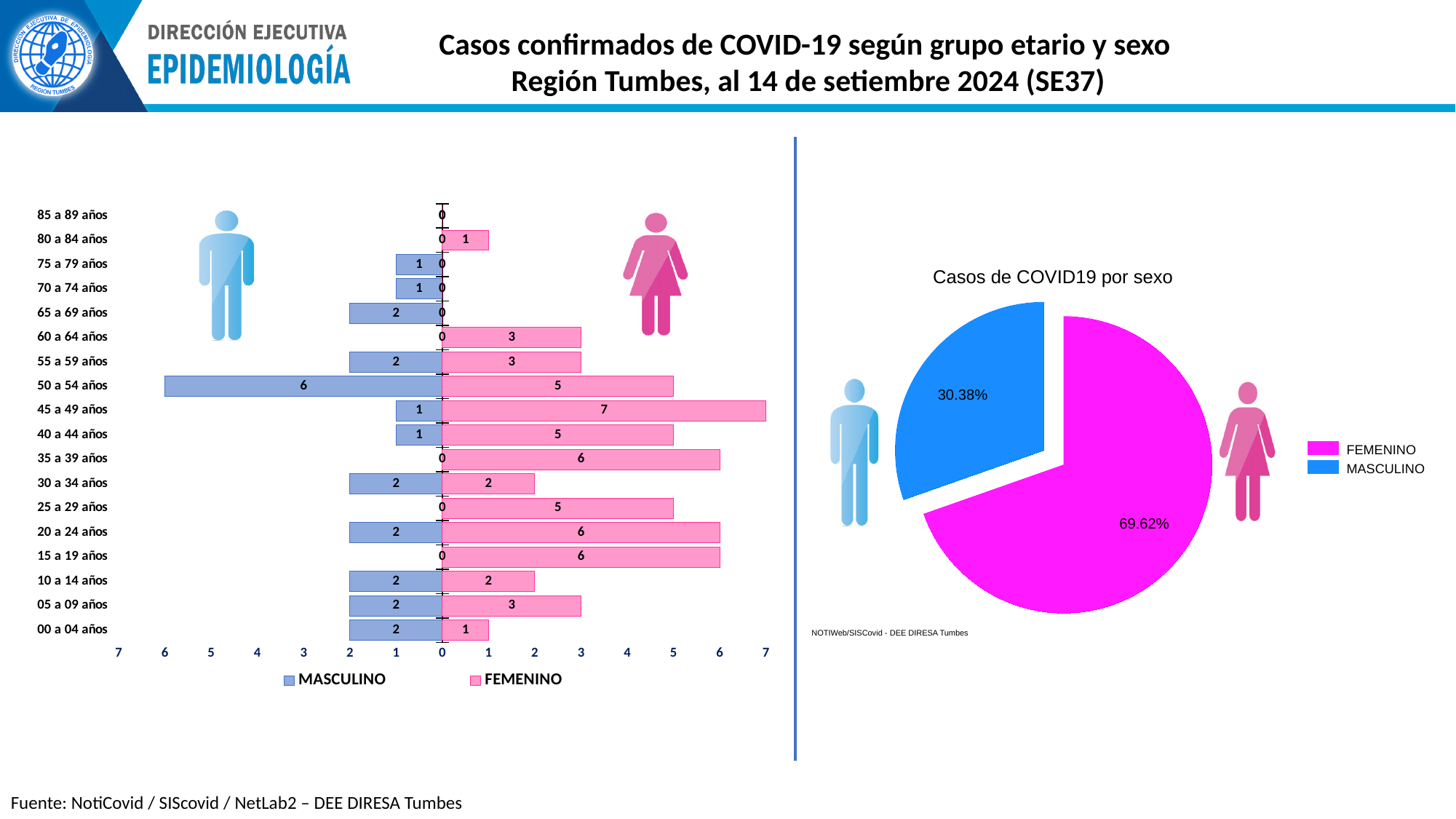
In the left chart (age group and sex), what is the difference between the FEMENINO and MASCULINO values for 45 a 49 años? 6 In the left chart (age group and sex), what is the MASCULINO value for 50 a 54 años? 6 In the left chart (age group and sex), which age group has the highest FEMENINO value? 45 a 49 años What kind of chart is the left chart showing cases by age group and sex? Bar chart In the left chart (age group and sex), how many series does the legend list? 2 In the left chart (age group and sex), what is the FEMENINO value for 45 a 49 años? 7 In the pie chart 'Casos de COVID19 por sexo', what share is MASCULINO? 30.38% In the left chart (age group and sex), what is the FEMENINO value for 20 a 24 años? 6 In the pie chart 'Casos de COVID19 por sexo', what share is FEMENINO? 69.62% In the left chart (age group and sex), which is larger for 50 a 54 años: MASCULINO or FEMENINO? MASCULINO In the left chart (age group and sex), how many age groups are shown? 18 In the left chart (age group and sex), which age group has the highest MASCULINO value? 50 a 54 años